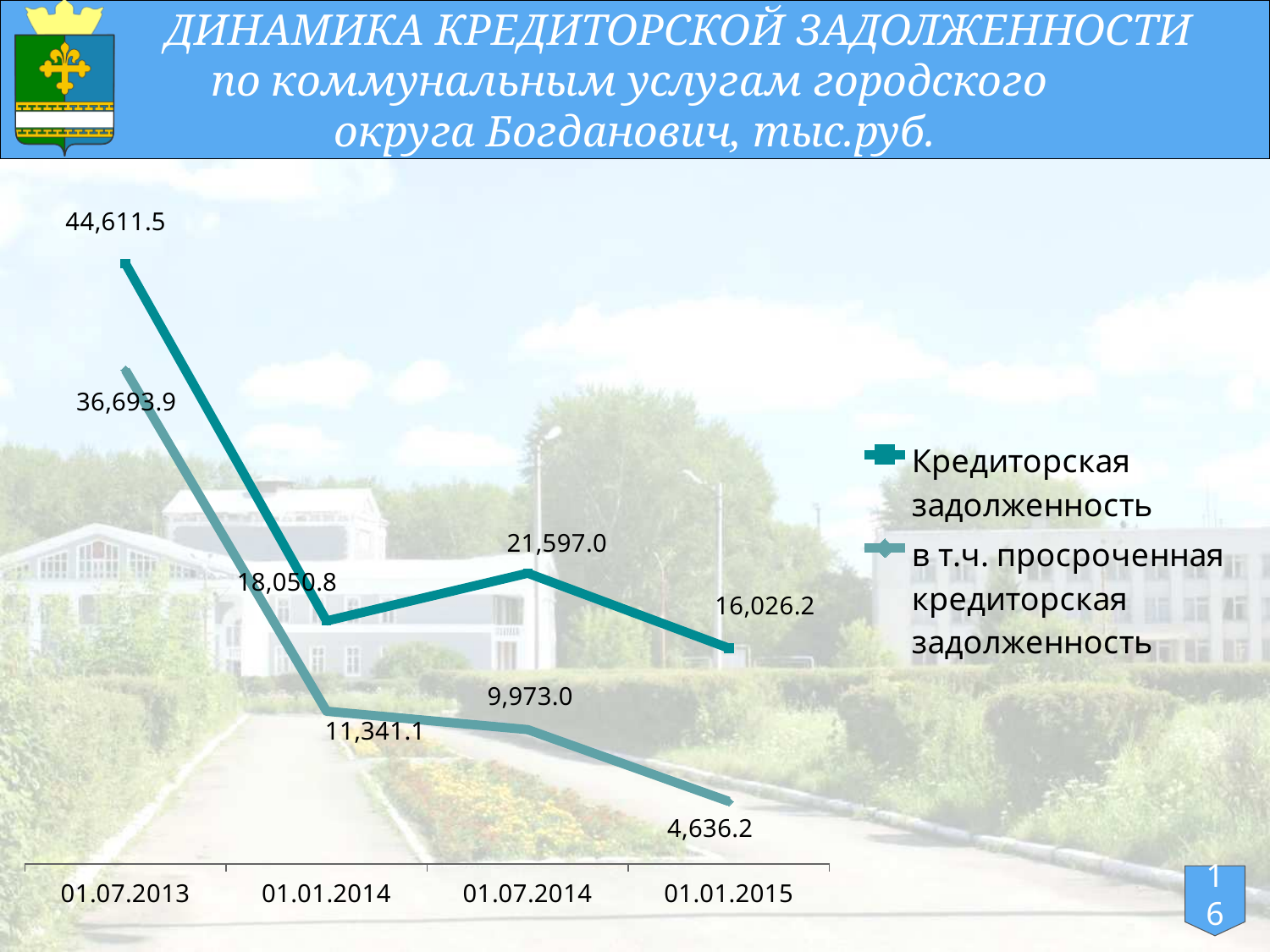
What kind of chart is shown on the slide? line chart What is the value of Кредиторская задолженность on 01.07.2014? 21,597.0 What is the difference between Кредиторская задолженность and в т.ч. просроченная кредиторская задолженность on 01.07.2013? 7,917.6 How many series does the legend list? 2 On which date is в т.ч. просроченная кредиторская задолженность lowest? 01.01.2015 What is the value of Кредиторская задолженность on 01.07.2013? 44,611.5 What is the value of в т.ч. просроченная кредиторская задолженность on 01.01.2014? 11,341.1 On which date is Кредиторская задолженность highest? 01.07.2013 What is the value of в т.ч. просроченная кредиторская задолженность on 01.01.2015? 4,636.2 How many dates are shown on the x axis? 4 By how much did Кредиторская задолженность decrease from 01.07.2013 to 01.01.2015? 28,585.3 Which is larger: Кредиторская задолженность on 01.01.2014 or on 01.07.2014? 01.07.2014